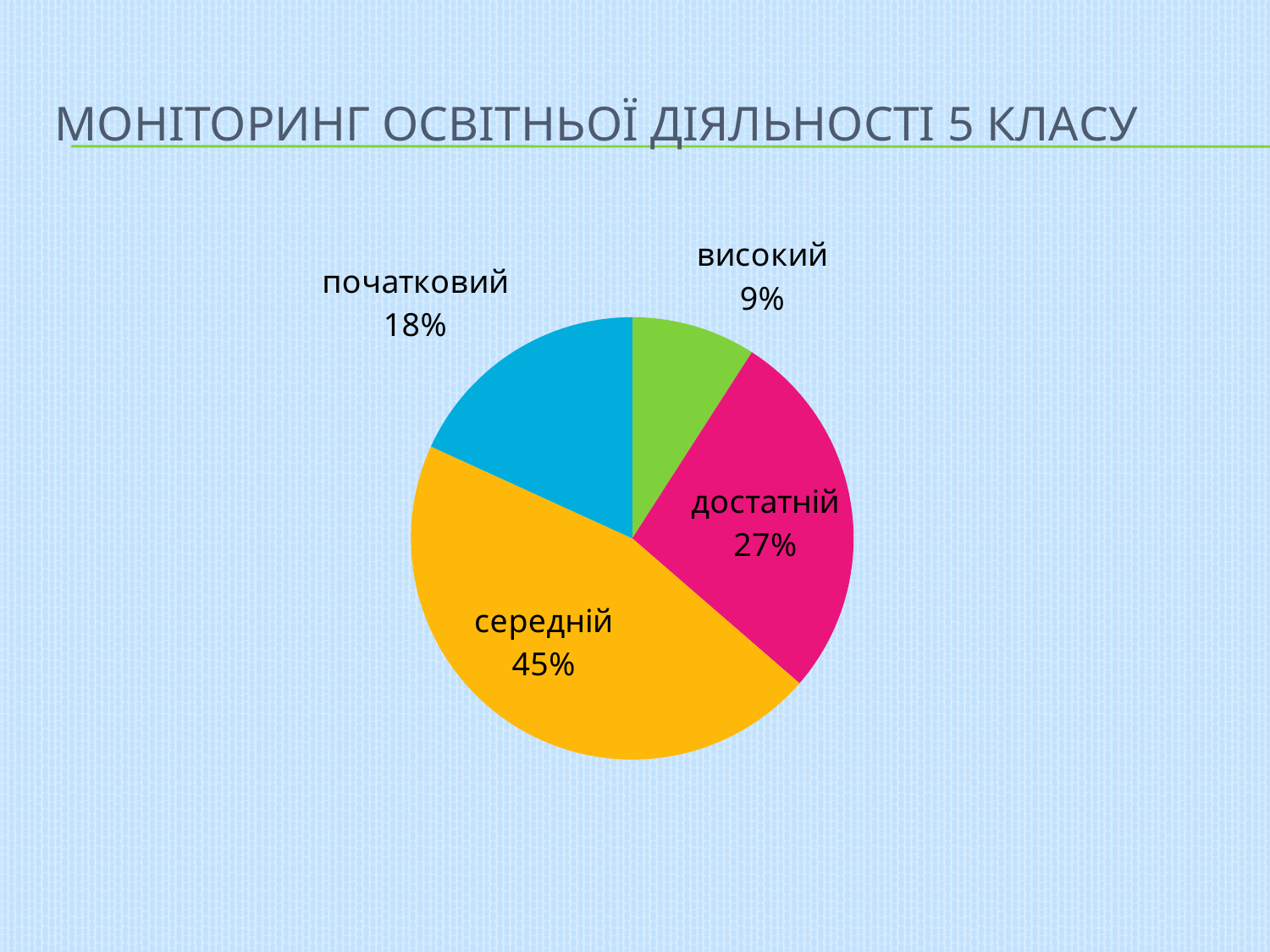
What share of the pie does the "середній" slice represent? 45% What is the value shown for "високий"? 9% What is the difference between the shares of "початковий" and "високий"? 9% What is the value shown for "достатній"? 27% What is the difference between the shares of "середній" and "достатній"? 18% How many slices does the pie chart have? 4 Which is larger, the share for "достатній" or the share for "початковий"? достатній What is the value shown for "початковий"? 18% Which category has the largest slice of the pie? середній What kind of chart is shown on the slide? pie chart What is the title of the slide containing the chart? МОНІТОРИНГ ОСВІТНЬОЇ ДІЯЛЬНОСТІ 5 КЛАСУ Which category has the smallest slice of the pie? високий